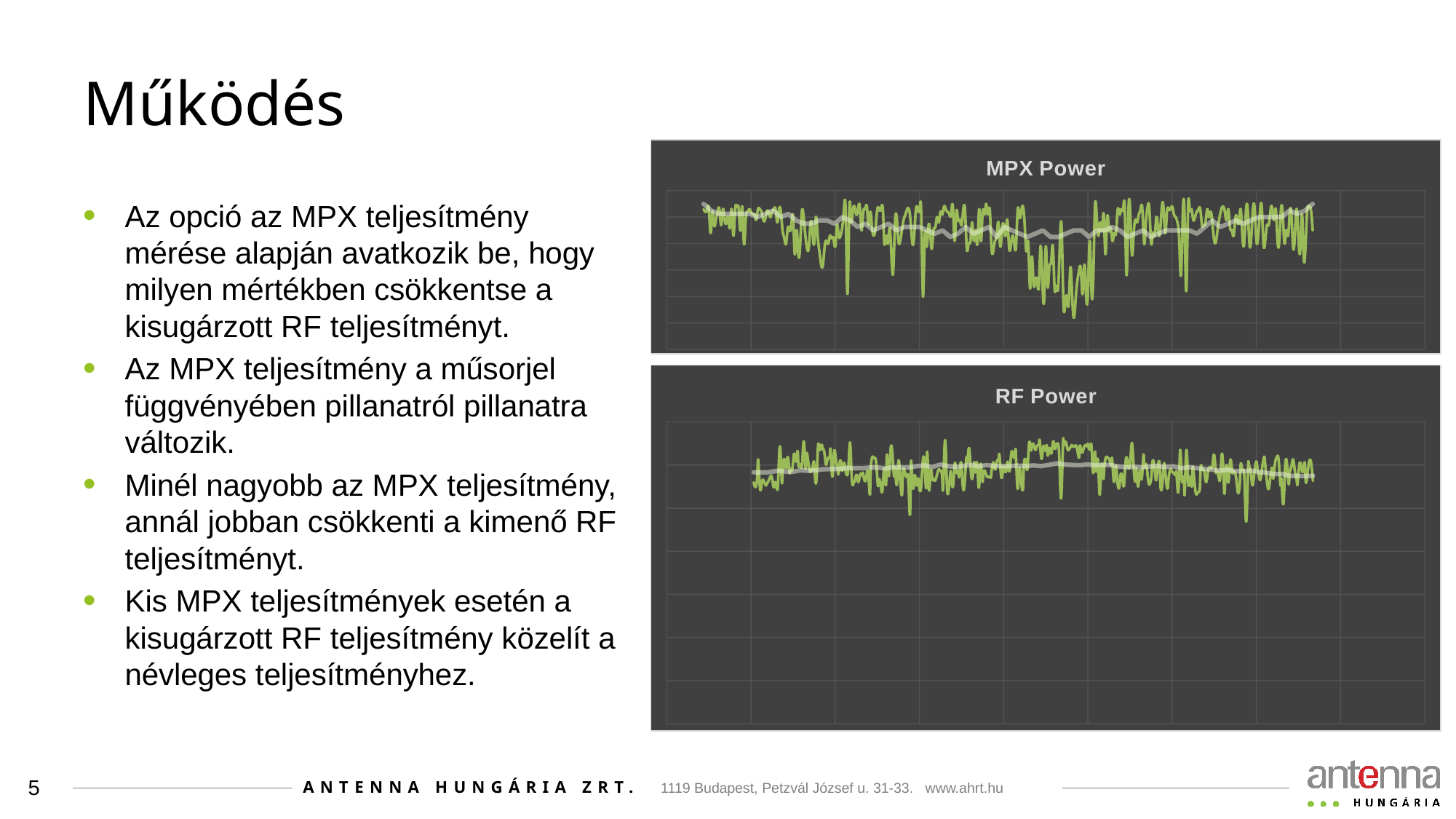
What type of chart is the MPX Power chart? line chart What is the title of the bottom chart on the slide? RF Power What is the title of the top chart on the slide? MPX Power What type of chart is the RF Power chart? line chart In the RF Power chart, does the green line rise or fall in the middle section of the x axis compared with the start? rise In the MPX Power chart, does the green line dip or rise in the middle section of the x axis compared with the start? dip